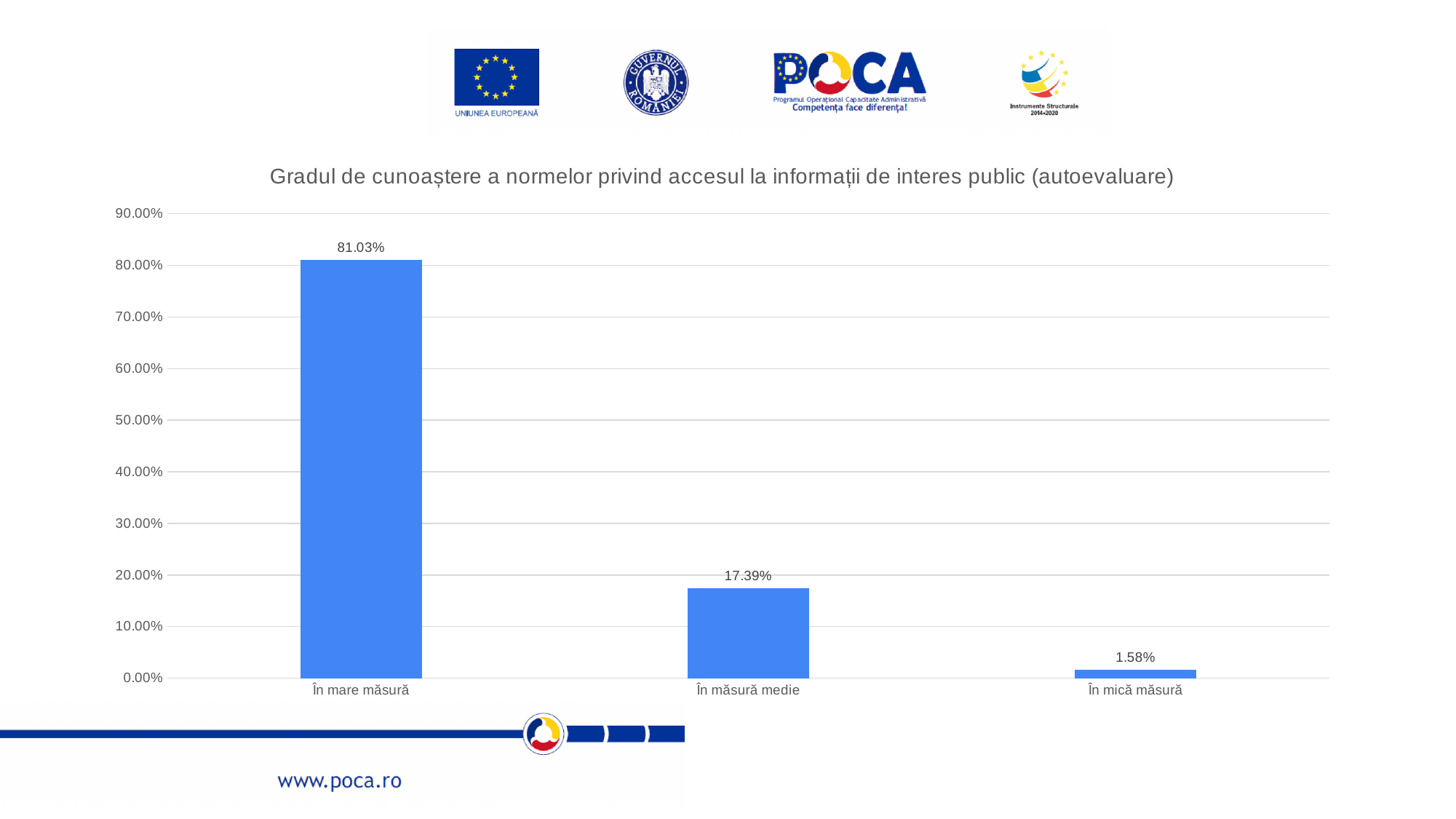
Is the value for 'În mare măsură' greater or less than 80.00%? greater What kind of chart is shown on the slide? bar chart How many categories are shown on the x axis? 3 What is the value for 'În mare măsură'? 81.03% What is the value for 'În mică măsură'? 1.58% Which category has the highest value? În mare măsură What is the title of the chart? Gradul de cunoaștere a normelor privind accesul la informații de interes public (autoevaluare) What is the difference between the values for 'În mare măsură' and 'În măsură medie'? 63.64% Which category has the lowest value? În mică măsură What is the value for 'În măsură medie'? 17.39% What is the difference between the values for 'În măsură medie' and 'În mică măsură'? 15.81% Which is larger, the value for 'În măsură medie' or 'În mică măsură'? În măsură medie